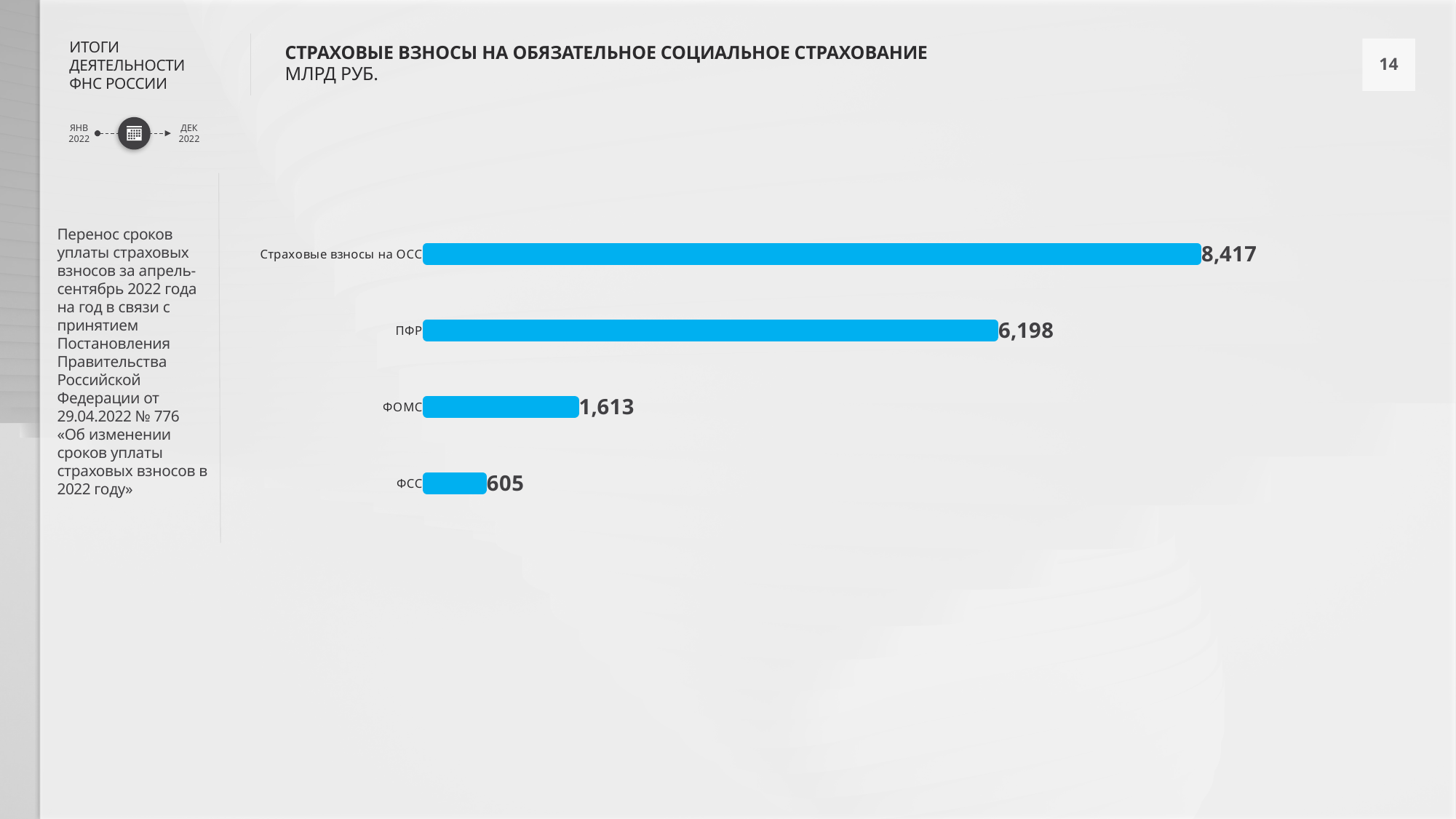
What is the value for ФОМС? 1,613 What is the difference between the values for ПФР and ФОМС? 4,585 Which category has the lowest value? ФСС What kind of chart is shown on the slide? Bar chart What is the value for Страховые взносы на ОСС? 8,417 Which is larger, the value for ПФР or the value for ФОМС? ПФР What is the value for ПФР? 6,198 What is the value for ФСС? 605 What is the difference between the values for ФОМС and ФСС? 1,008 How many categories are shown in the chart? 4 In what units are the chart values given, according to the subtitle? МЛРД РУБ. Which category has the highest value? Страховые взносы на ОСС